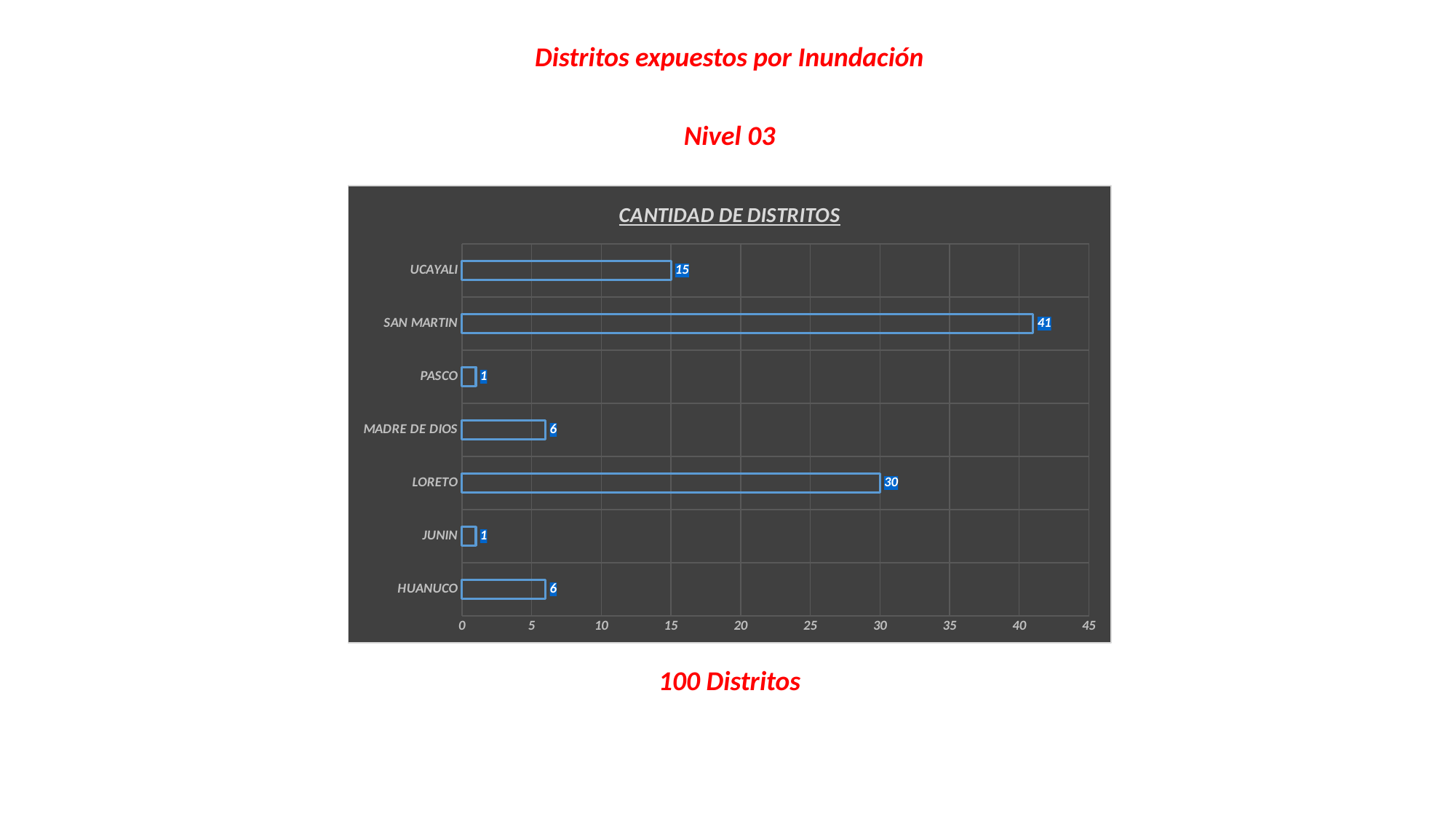
What kind of chart is shown on the slide? bar chart What is the difference between the values for UCAYALI and HUANUCO? 9 What is the value for LORETO? 30 What is the value for MADRE DE DIOS? 6 Which category has the highest value? SAN MARTIN Is the value for SAN MARTIN greater or less than 40? greater What is the difference between the values for SAN MARTIN and LORETO? 11 How many categories are shown in the chart? 7 What is the value for UCAYALI? 15 Which is larger, the value for LORETO or the value for UCAYALI? LORETO What is the title of the chart? CANTIDAD DE DISTRITOS What is the value for SAN MARTIN? 41